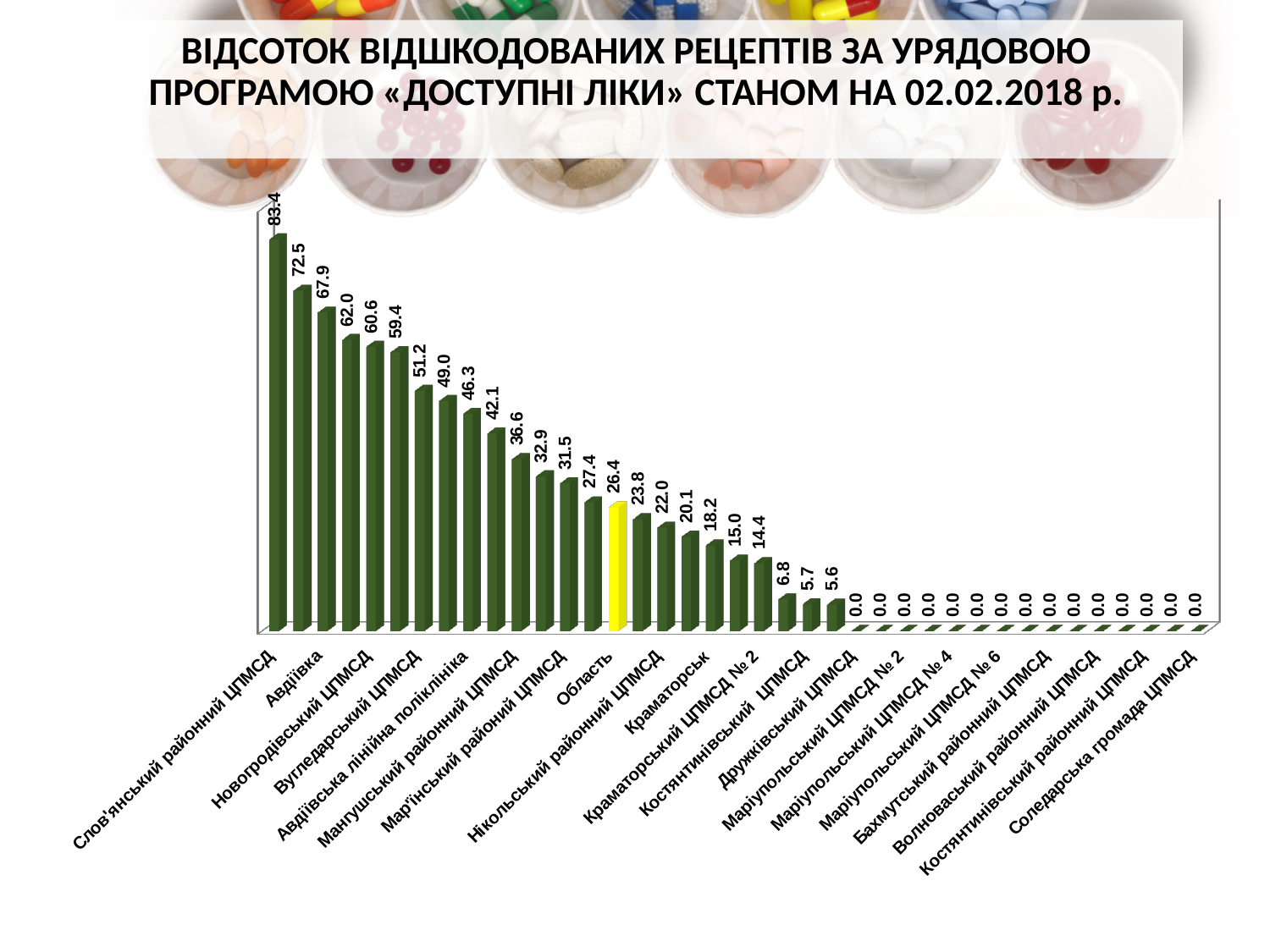
Which is larger, the value for Слов'янський районний ЦПМСД or the value for Область? Слов'янський районний ЦПМСД Do the values rise or fall from left to right along the x axis? fall Which category has the highest value in the chart? Слов'янський районний ЦПМСД What is the value of the yellow bar labelled Область? 26.4 What is the highest value shown in the chart? 83.4 What is the value shown for Соледарська громада ЦПМСД? 0.0 What is the value for Слов'янський районний ЦПМСД? 83.4 What is the difference between the value for Слов'янський районний ЦПМСД and the value for Область? 57.0 What is the lowest value shown in the chart? 0.0 What type of chart is shown on the slide? bar chart Which bar is highlighted in a different colour (yellow) from the others? Область How many bars in the chart have a value of 0.0? 15